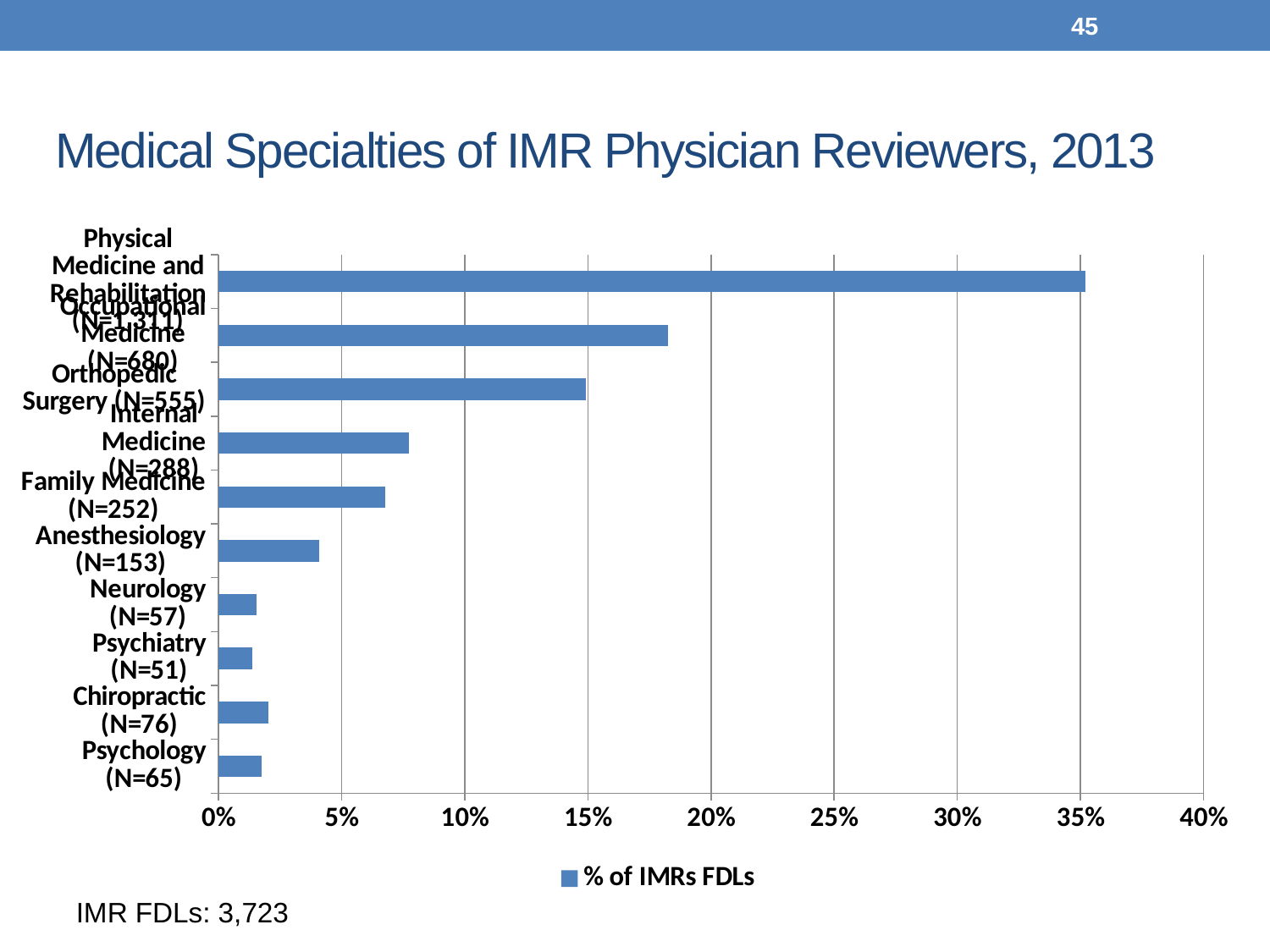
How many medical specialties are plotted in the chart? 10 Is the value for Internal Medicine (N=288) greater or less than 5%? greater Is the value for Physical Medicine and Rehabilitation greater or less than 30%? greater Which has a larger share of IMR FDLs, Occupational Medicine or Orthopedic Surgery? Occupational Medicine Which specialty has the highest share of IMR FDLs? Physical Medicine and Rehabilitation Which has a larger share of IMR FDLs, Chiropractic (N=76) or Psychiatry (N=51)? Chiropractic What kind of chart is shown on the slide? bar chart Is the value for Anesthesiology (N=153) greater or less than 5%? less How many series does the legend list? 1 What is the series name shown in the chart legend? % of IMRs FDLs